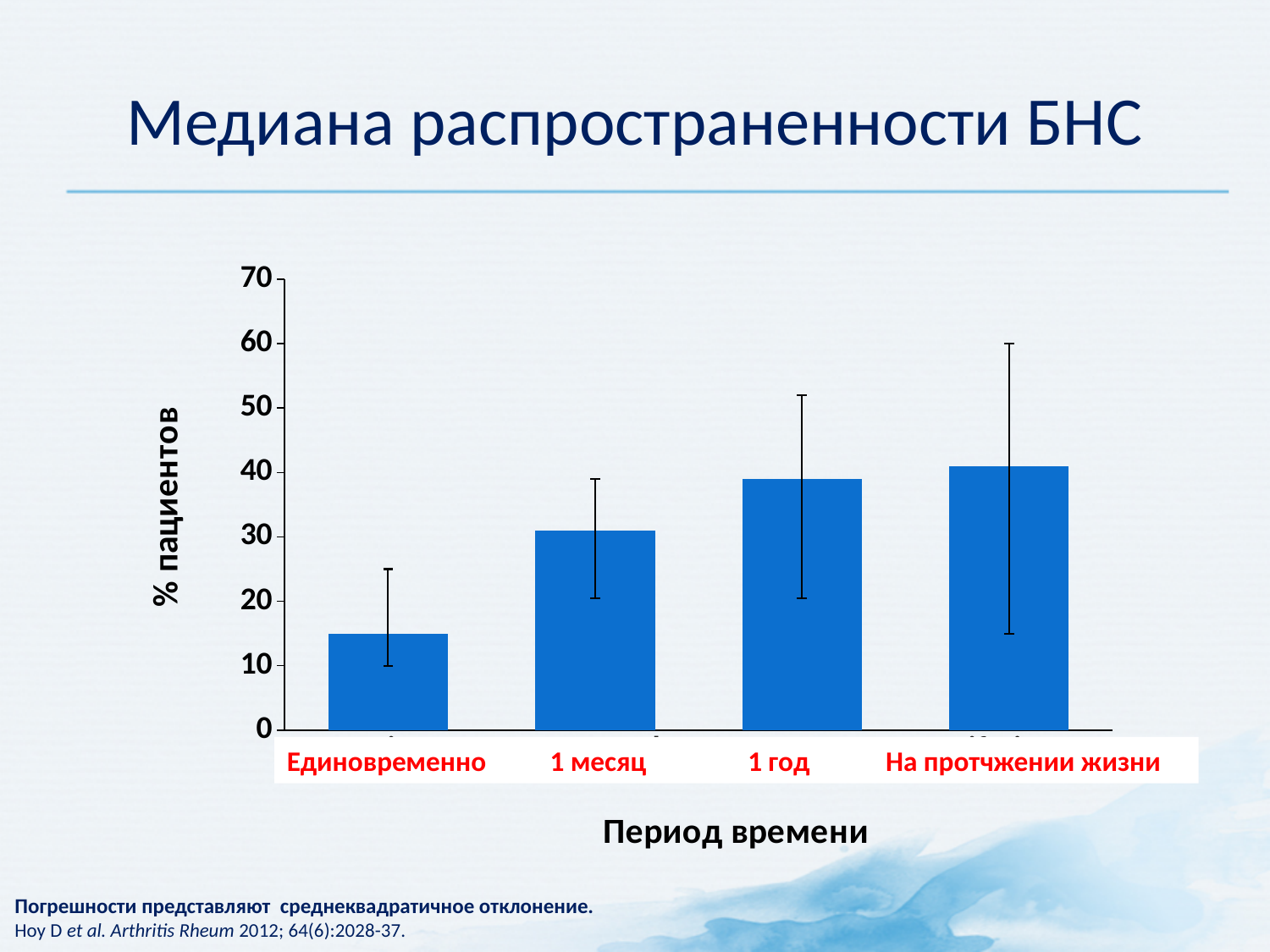
Is the value for На протчжении жизни greater or less than 30? greater How many categories are shown on the x axis of the chart? 4 Which category has the lowest value in the chart? Единовременно Is the value for 1 год greater or less than 30? greater Is the value for 1 месяц greater or less than 40? less What kind of chart is shown on the slide? bar chart What is the title of the chart's horizontal axis? Период времени Do the bar values rise or fall from left to right along the x axis? rise What is the title of the chart's vertical axis? % пациентов Which is larger, the value for 1 месяц or the value for Единовременно? 1 месяц